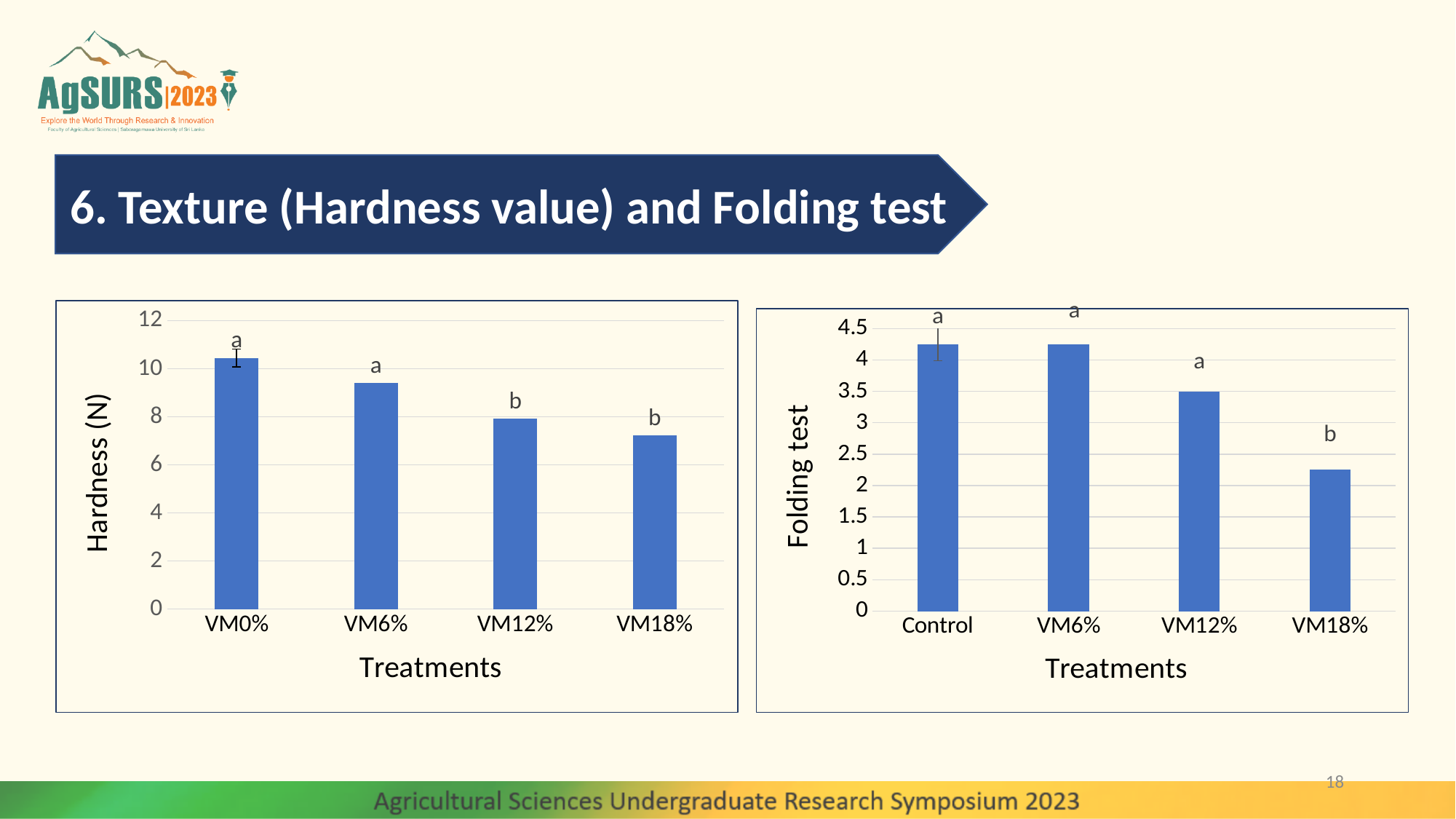
In the Hardness (N) chart on the left, how many treatments are shown on the x axis? 4 In the Hardness (N) chart on the left, is the value for VM6% greater or less than 8? greater In the Folding test chart on the right, which treatment has the lowest folding test value? VM18% In the Hardness (N) chart on the left, do the values rise or fall from VM0% to VM18%? fall What kind of chart is the Hardness (N) chart on the left? bar chart In the Hardness (N) chart on the left, which treatment has the highest hardness? VM0% In the Hardness (N) chart on the left, which is larger, the value for VM6% or VM12%? VM6% In the Hardness (N) chart on the left, is the value for VM18% greater or less than 6? greater In the Folding test chart on the right, is the value for VM18% greater or less than 2.5? less In the Hardness (N) chart on the left, which treatment has the lowest hardness? VM18% In the Folding test chart on the right, what is the label of the y axis? Folding test